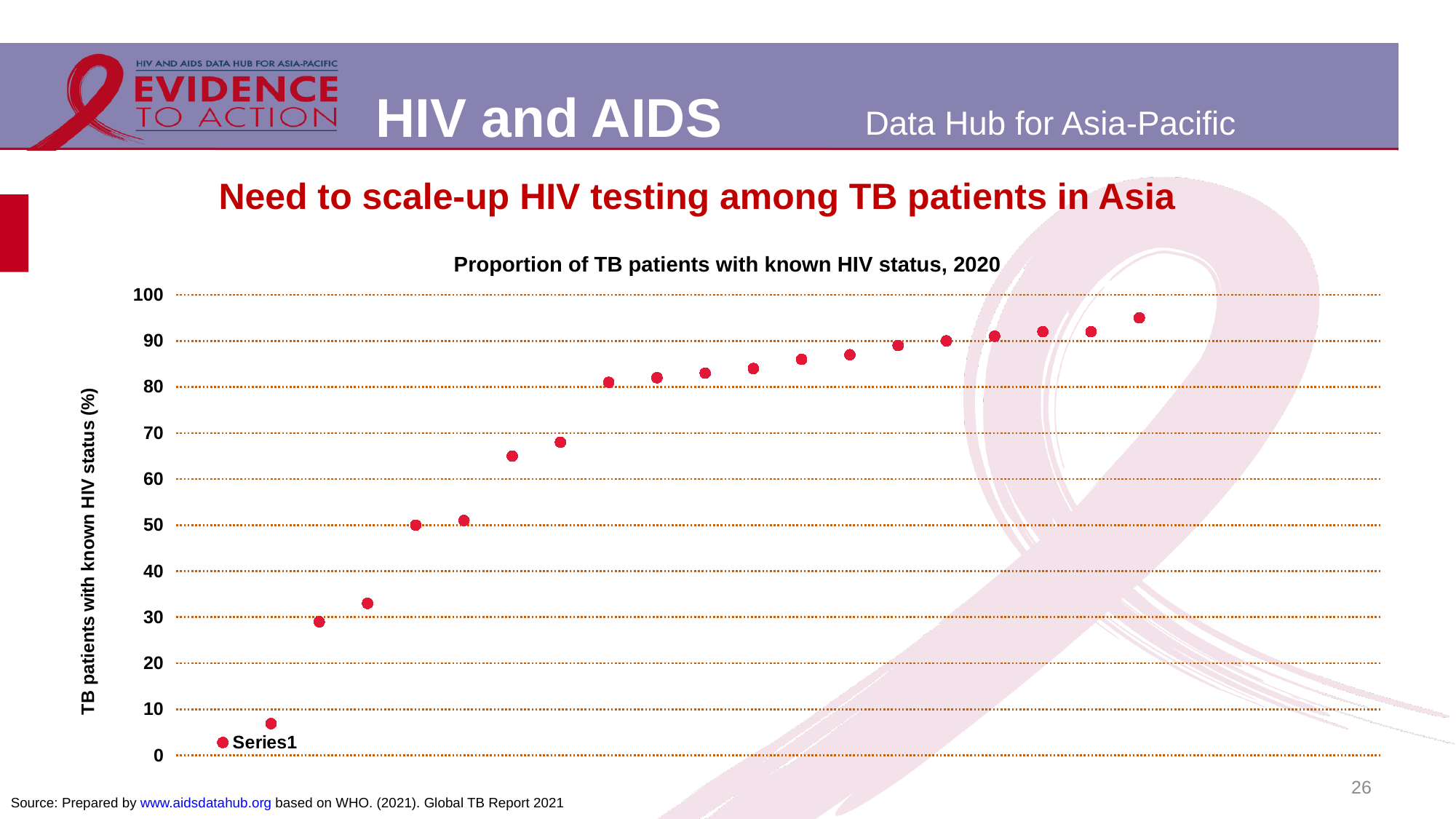
What is the title of the chart? Proportion of TB patients with known HIV status, 2020 How many plotted points lie below 40? 4 Is the highest plotted value greater or less than 90? greater What kind of chart is shown on the slide? scatter chart What is the label of the vertical axis? TB patients with known HIV status (%) Do the plotted values rise or fall from left to right along the x axis? rise What is the maximum value shown on the vertical axis? 100 How many data points are plotted on the chart? 20 Is the second-lowest plotted value greater or less than 20? less Is the lowest plotted value greater or less than 10? less